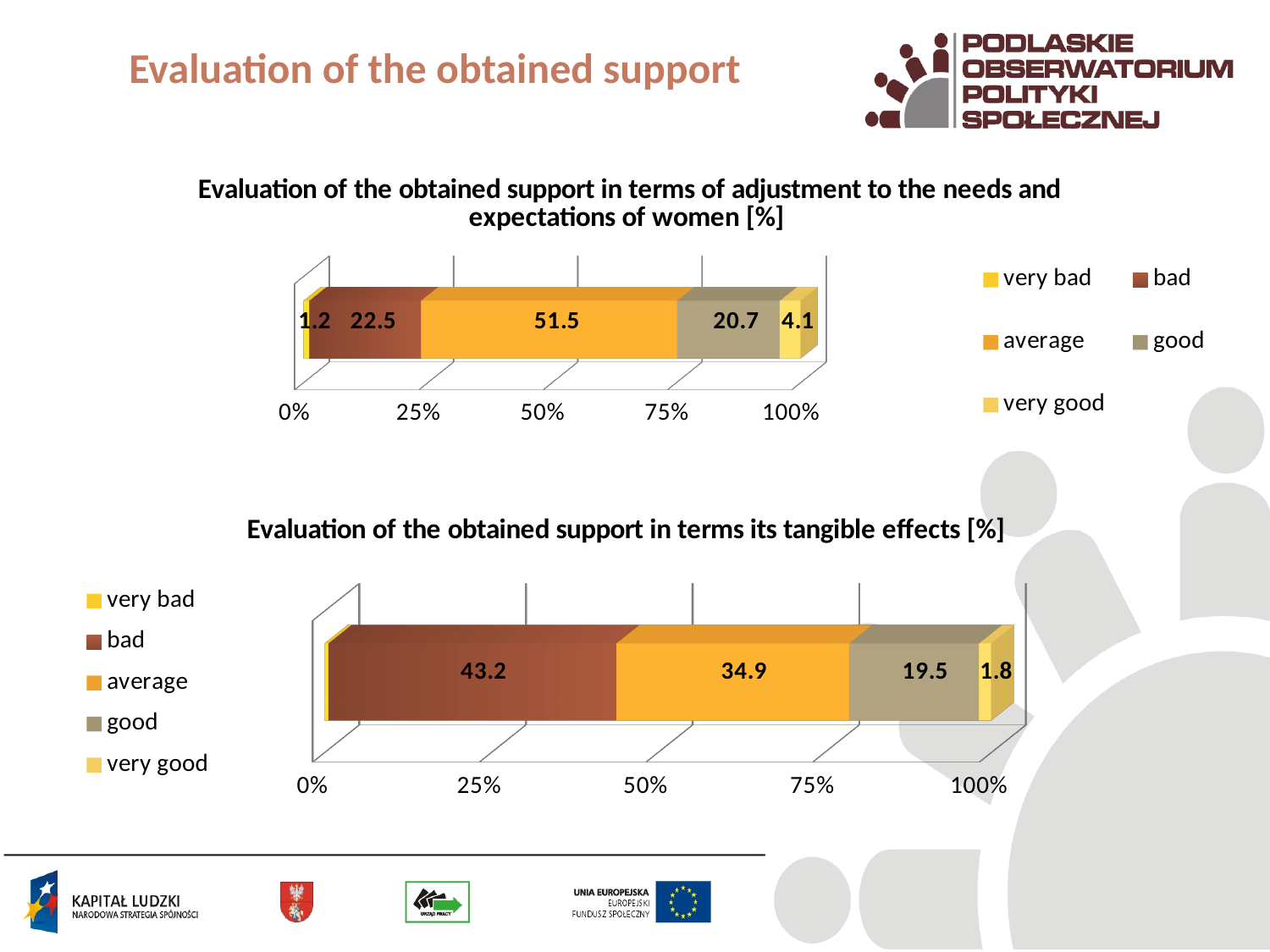
In the top chart (adjustment to the needs and expectations of women), which category has the lowest value? very bad What kind of chart is the top chart (adjustment to the needs and expectations of women)? stacked bar chart In the top chart (adjustment to the needs and expectations of women), what is the value for "bad"? 22.5 In the top chart (adjustment to the needs and expectations of women), which category has the highest value? average In the top chart (adjustment to the needs and expectations of women), which is larger, the value for "bad" or the value for "good"? bad In the top chart (adjustment to the needs and expectations of women), what is the value for "very good"? 4.1 In the bottom chart (tangible effects), what is the value for "bad"? 43.2 In the bottom chart (tangible effects), what is the difference between the values for "bad" and "average"? 8.3 In the top chart (adjustment to the needs and expectations of women), what is the value for "average"? 51.5 In the bottom chart (tangible effects), which category has the highest value? bad How many series does the legend of the bottom chart (tangible effects) list? 5 In the bottom chart (tangible effects), what is the value for "good"? 19.5